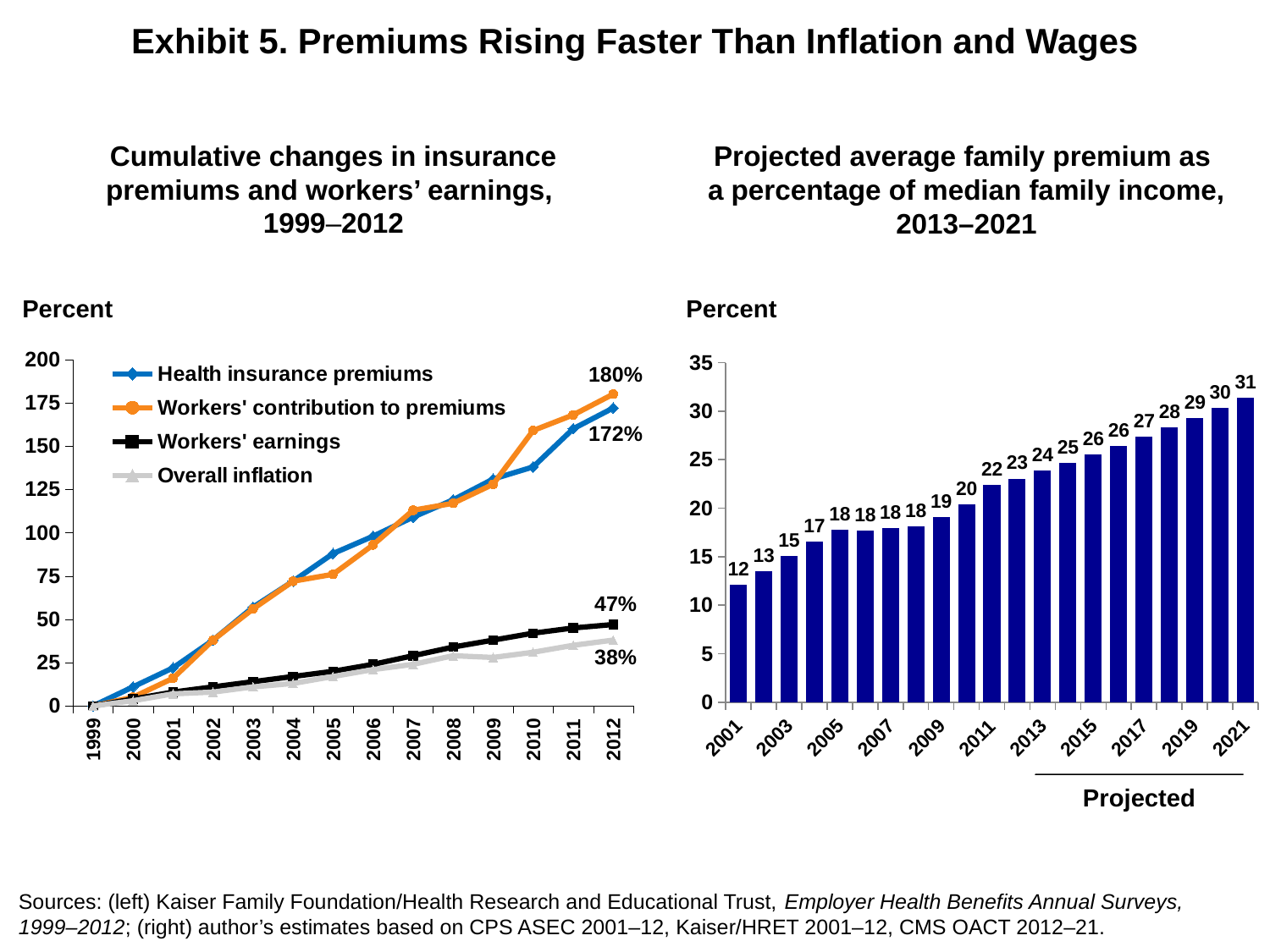
What kind of chart is the right chart (Projected average family premium as a percentage of median family income)? bar chart In the right chart (Projected average family premium as a percentage of median family income), what is the difference between the 2021 value and the 2001 value? 19 In the left chart (Cumulative changes in insurance premiums and workers' earnings), is the value for Health insurance premiums in 2010 greater or less than 125? greater In the right chart (Projected average family premium as a percentage of median family income), which year has the lowest value? 2001 In the left chart (Cumulative changes in insurance premiums and workers' earnings), what is the 2012 value for Workers' contribution to premiums? 180% In the right chart (Projected average family premium as a percentage of median family income), what is the value for 2001? 12 In the left chart (Cumulative changes in insurance premiums and workers' earnings), which is higher in 2012: Health insurance premiums or Workers' earnings? Health insurance premiums In the right chart (Projected average family premium as a percentage of median family income), what is the value for 2021? 31 In the left chart (Cumulative changes in insurance premiums and workers' earnings), what is the 2012 value for Overall inflation? 38% In the right chart (Projected average family premium as a percentage of median family income), do the values generally rise or fall from 2001 to 2021? rise In the right chart (Projected average family premium as a percentage of median family income), how many bars are plotted? 21 In the left chart (Cumulative changes in insurance premiums and workers' earnings), how many series does the legend list? 4